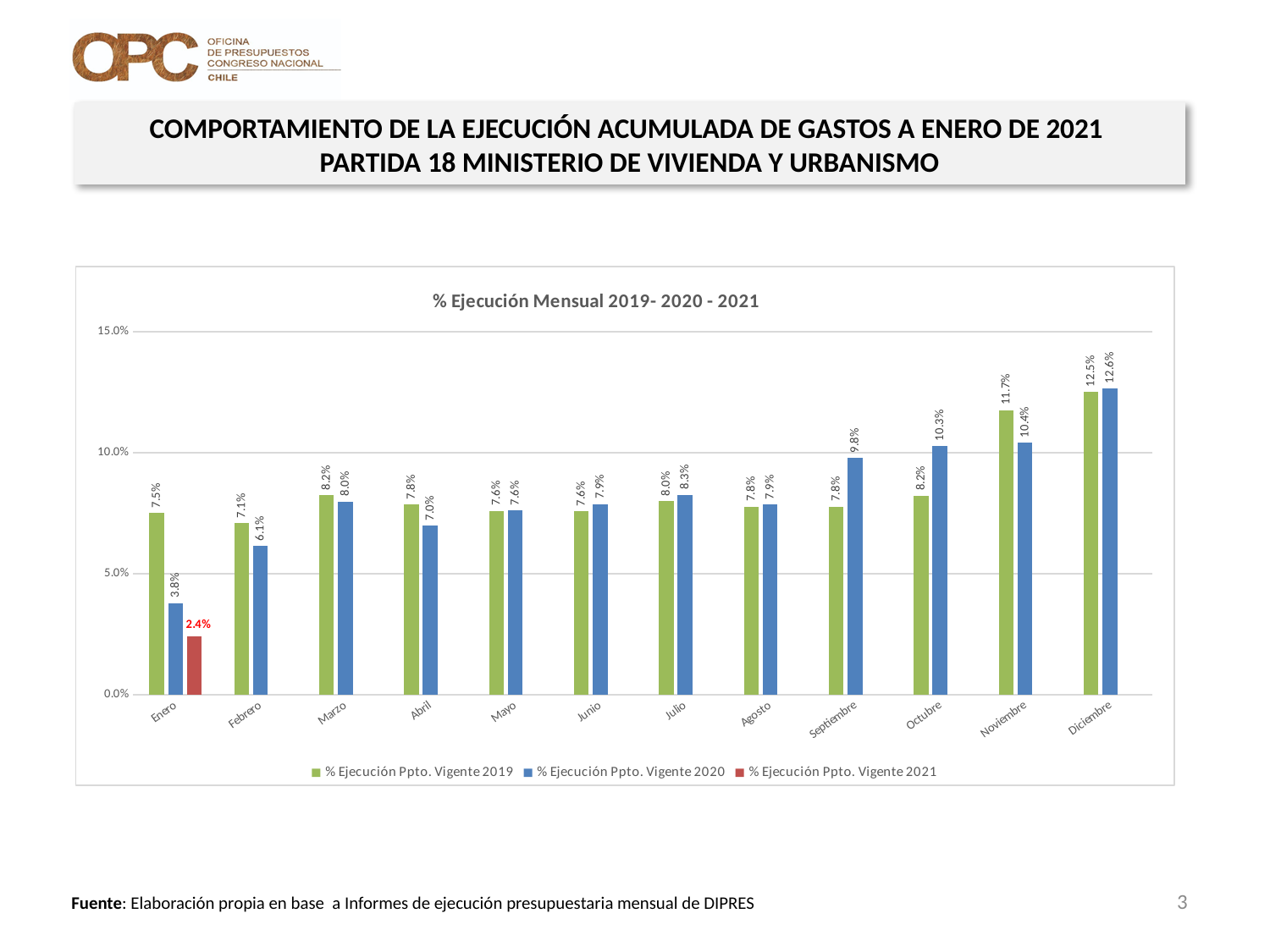
What is the difference between the 2019 and 2020 values in Enero? 3.7% What is the value for % Ejecución Ppto. Vigente 2020 in Enero? 3.8% Which is larger in Abril: the 2019 value or the 2020 value? 2019 (7.8%) How many months are shown on the x axis? 12 What is the value for % Ejecución Ppto. Vigente 2019 in Noviembre? 11.7% What is the value for % Ejecución Ppto. Vigente 2020 in Septiembre? 9.8% What kind of chart is shown? Bar chart What is the value for % Ejecución Ppto. Vigente 2021 in Enero? 2.4% Which month has the highest value for % Ejecución Ppto. Vigente 2020? Diciembre Which month has the lowest value for % Ejecución Ppto. Vigente 2019? Febrero What is the title of the chart? % Ejecución Mensual 2019- 2020 - 2021 How many series does the legend list? 3